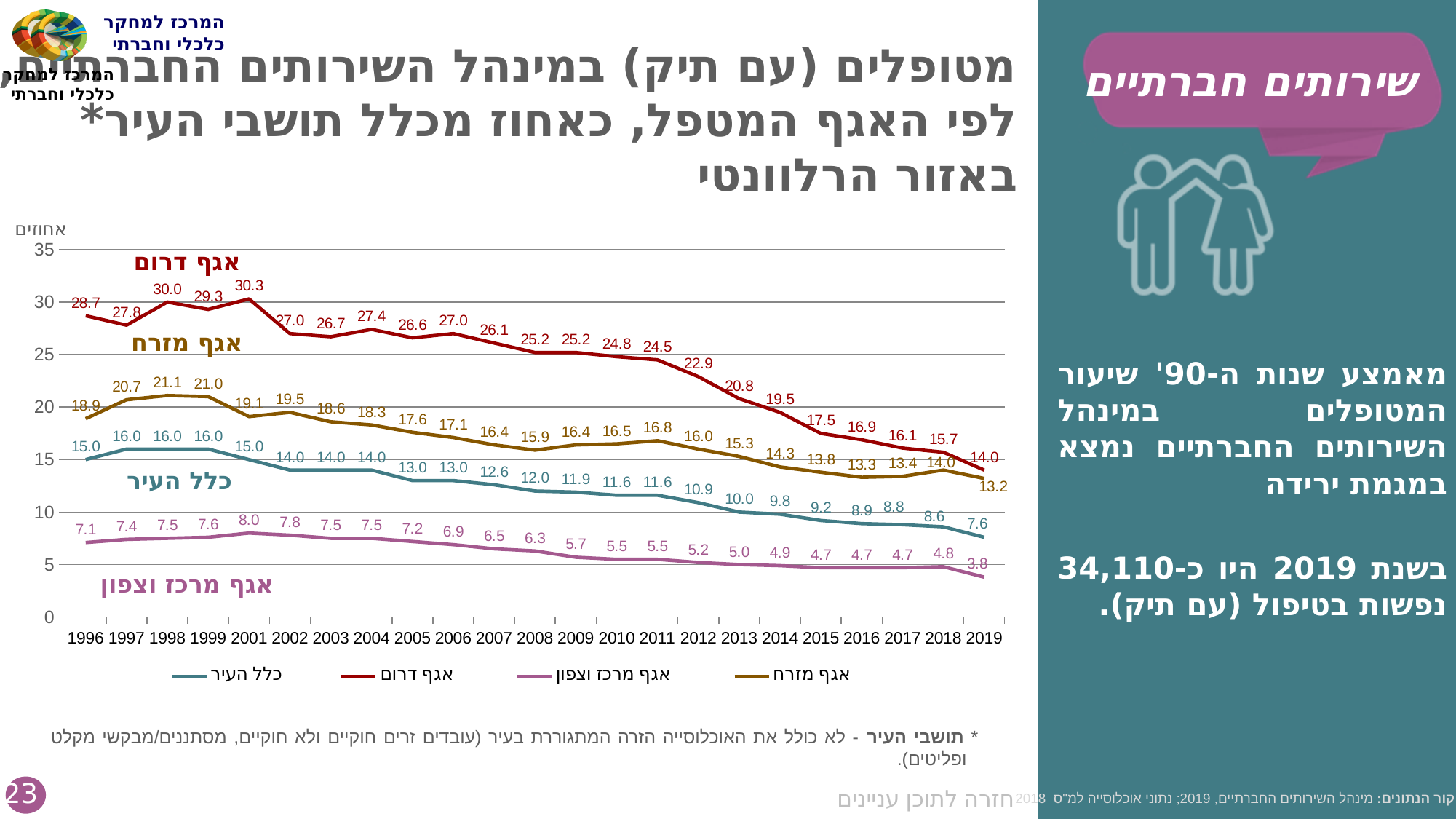
How many years are plotted on the x axis? 23 Which is larger in 2018: the value for אגף מזרח or the value for כלל העיר? אגף מזרח What is the value for כלל העיר in 1996? 15.0 What is the difference between the אגף דרום value in 1996 and its value in 2019? 14.7 Does the כלל העיר series generally rise or fall from 1996 to 2019? fall What is the value for אגף מרכז וצפון in 2019? 3.8 What is the value for אגף מזרח in 2011? 16.8 What type of chart is shown on the slide? line chart In which year does the אגף דרום series reach its highest value? 2001 What is the value for אגף דרום in 2019? 14.0 How many series does the chart legend list? 4 Which series has the lowest value in 2019? אגף מרכז וצפון